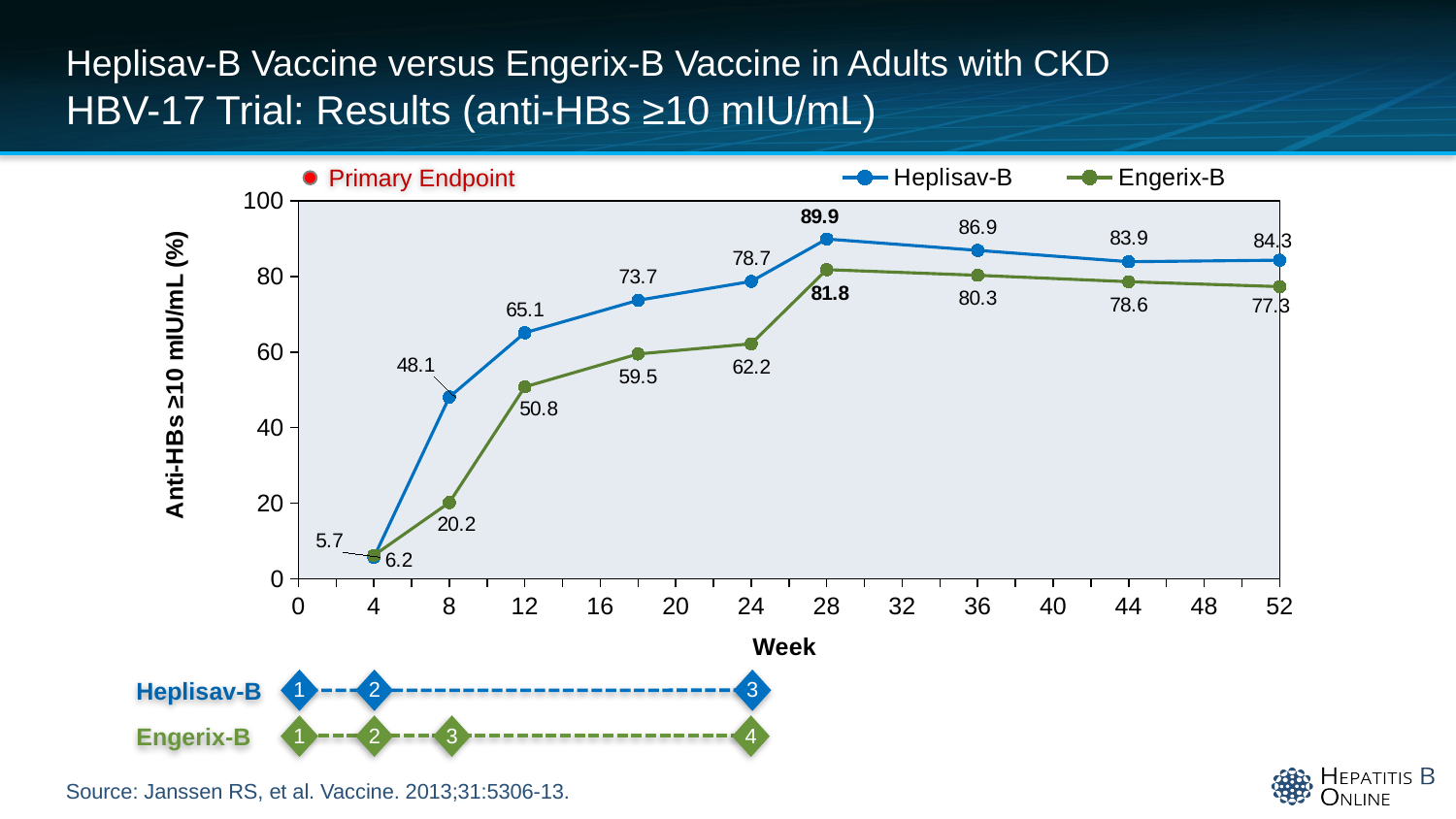
Does the Engerix-B line rise or fall from week 28 to week 52? Fall At which week does Heplisav-B reach its highest value? Week 28 What is the difference between the Heplisav-B and Engerix-B values at week 52? 7.0 What is the difference between the Heplisav-B and Engerix-B values at week 28? 8.1 What is the Engerix-B value at week 44? 78.6 At week 8, which series has the larger value, Heplisav-B or Engerix-B? Heplisav-B What is the Heplisav-B value at week 28? 89.9 Is the Engerix-B value at week 24 greater or less than 80? less What is the lowest value plotted for Engerix-B? 6.2 What is the Engerix-B value at week 12? 50.8 How many series does the legend list? 2 What kind of chart is shown on the slide? Line chart